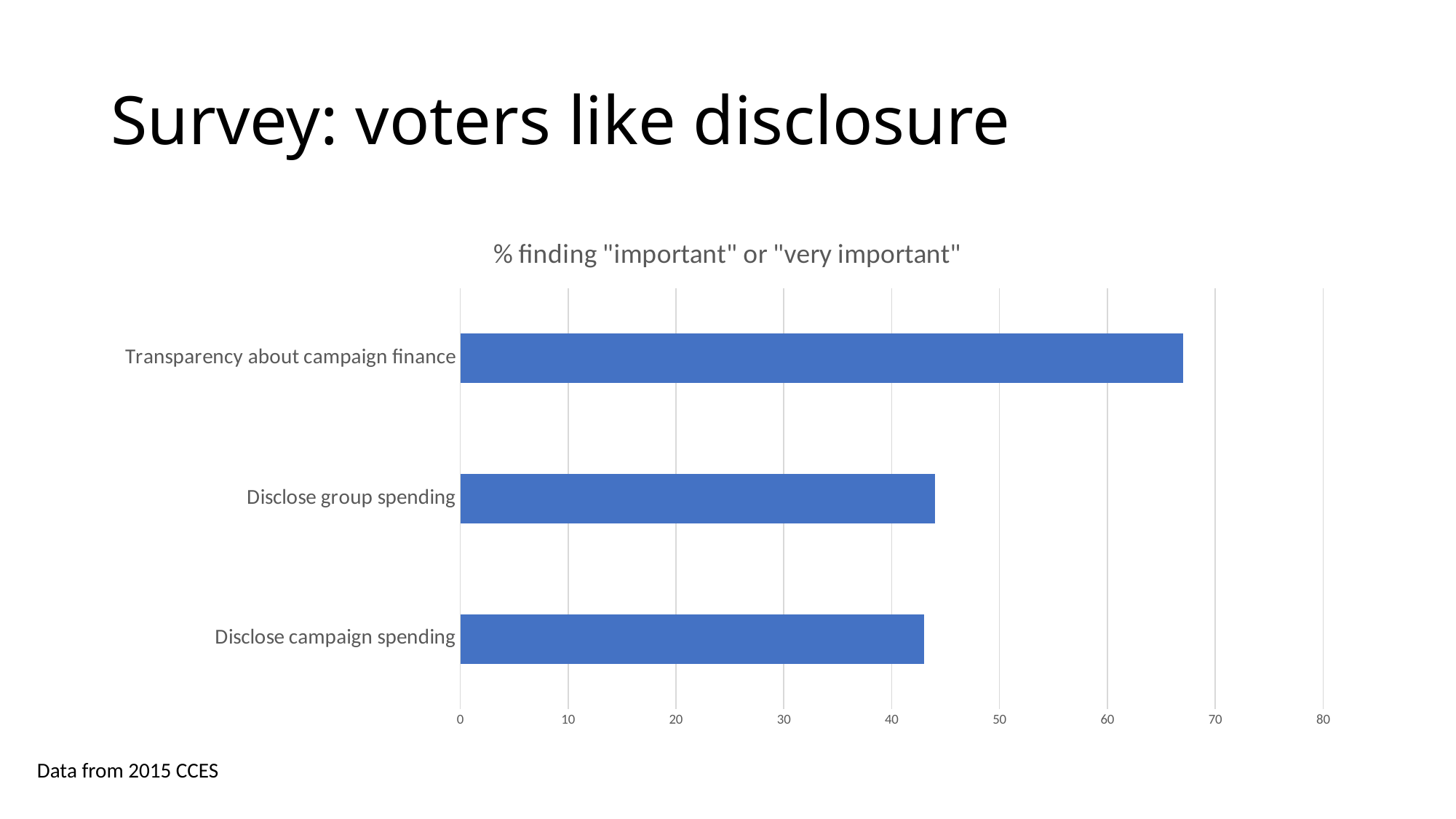
Which category has the highest value in the chart? Transparency about campaign finance What colour are the bars in the chart? blue How many categories are plotted in the chart? 3 Is the value for Transparency about campaign finance greater or less than 70? less What is the title of the chart? % finding "important" or "very important" What kind of chart is shown on the slide? bar chart Is the value for Transparency about campaign finance greater or less than 60? greater Is the value for Disclose group spending greater or less than 40? greater Which is larger, the value for Transparency about campaign finance or the value for Disclose group spending? Transparency about campaign finance